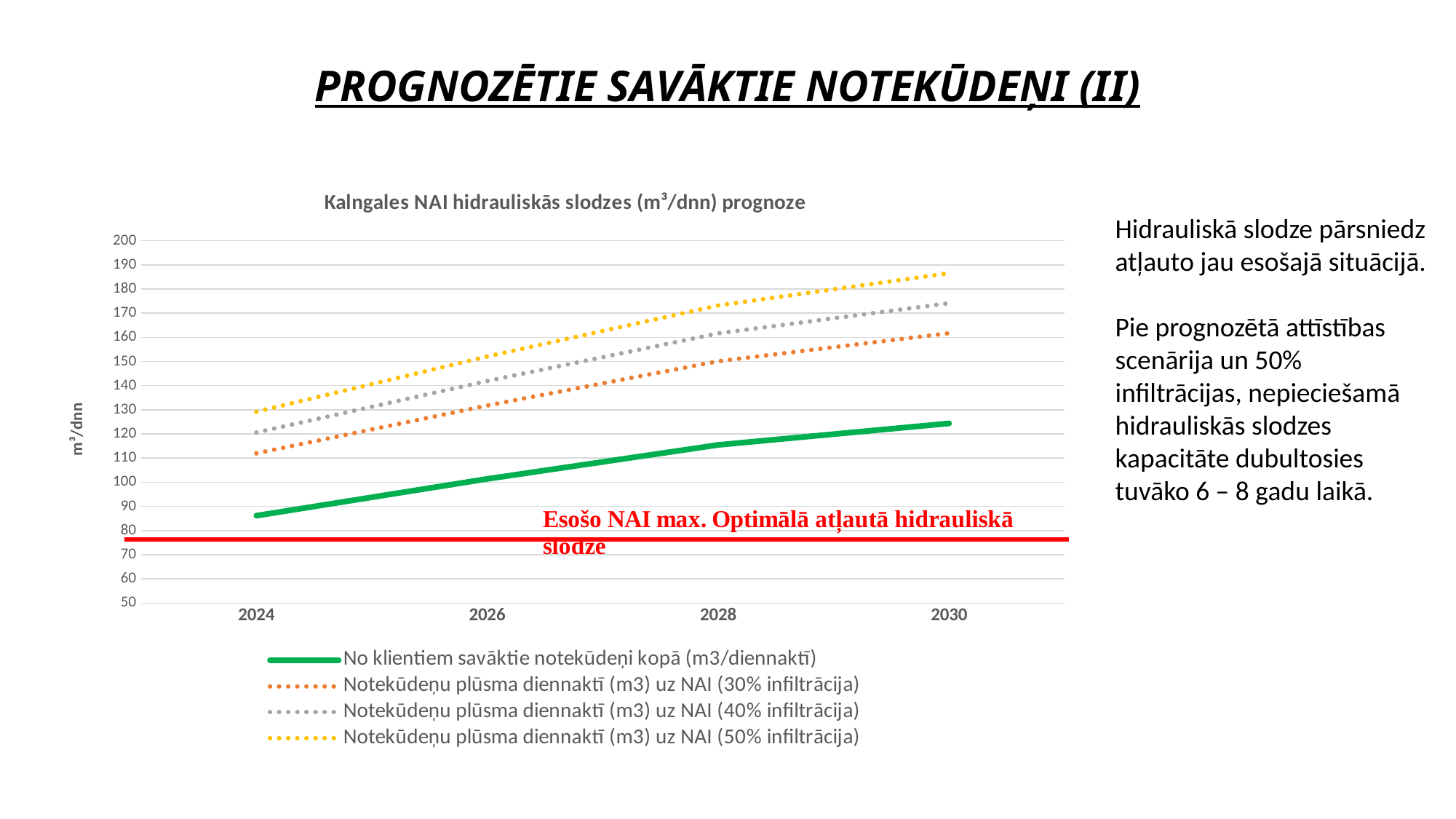
Does the series 'No klientiem savāktie notekūdeņi kopā (m3/diennaktī)' rise or fall from 2024 to 2030? rise Is the value for 'Notekūdeņu plūsma diennaktī (m3) uz NAI (50% infiltrācija)' in 2030 greater or less than 180? greater Is the value for 'No klientiem savāktie notekūdeņi kopā (m3/diennaktī)' in 2030 greater or less than 130? less How many years are labelled on the x axis of the chart? 4 Is the value for 'Notekūdeņu plūsma diennaktī (m3) uz NAI (30% infiltrācija)' in 2024 greater or less than 100? greater What kind of chart is shown on the slide? line chart What is the title of the chart? Kalngales NAI hidrauliskās slodzes (m³/dnn) prognoze Which series has the highest value in 2030? Notekūdeņu plūsma diennaktī (m3) uz NAI (50% infiltrācija) What is the label on the vertical axis of the chart? m³/dnn Which series has the lowest value in 2024? No klientiem savāktie notekūdeņi kopā (m3/diennaktī) How many series does the chart legend list? 4